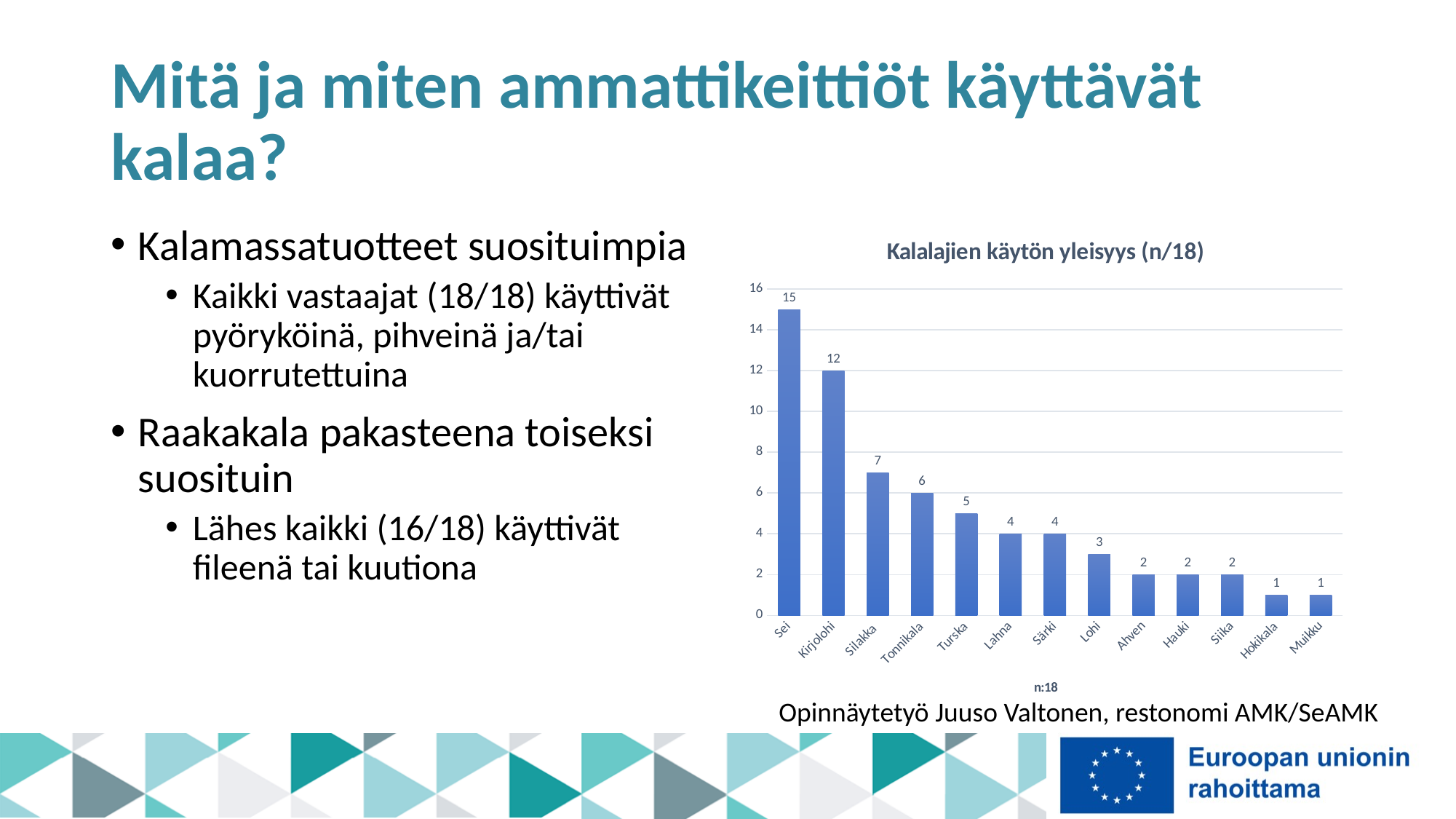
How many fish species are shown on the x axis? 13 Which is larger, the value for Silakka or the value for Lahna? Silakka What is the value for Tonnikala? 6 What is the difference between the values for Silakka and Turska? 2 What is the value for Kirjolohi? 12 Which fish species has the highest value? Sei What is the difference between the values for Sei and Kirjolohi? 3 What is the title of the chart? Kalalajien käytön yleisyys (n/18) What is the value for Sei? 15 Is the value for Kirjolohi greater or less than 10? greater What kind of chart is shown on the slide? Bar chart What is the value for Lohi? 3